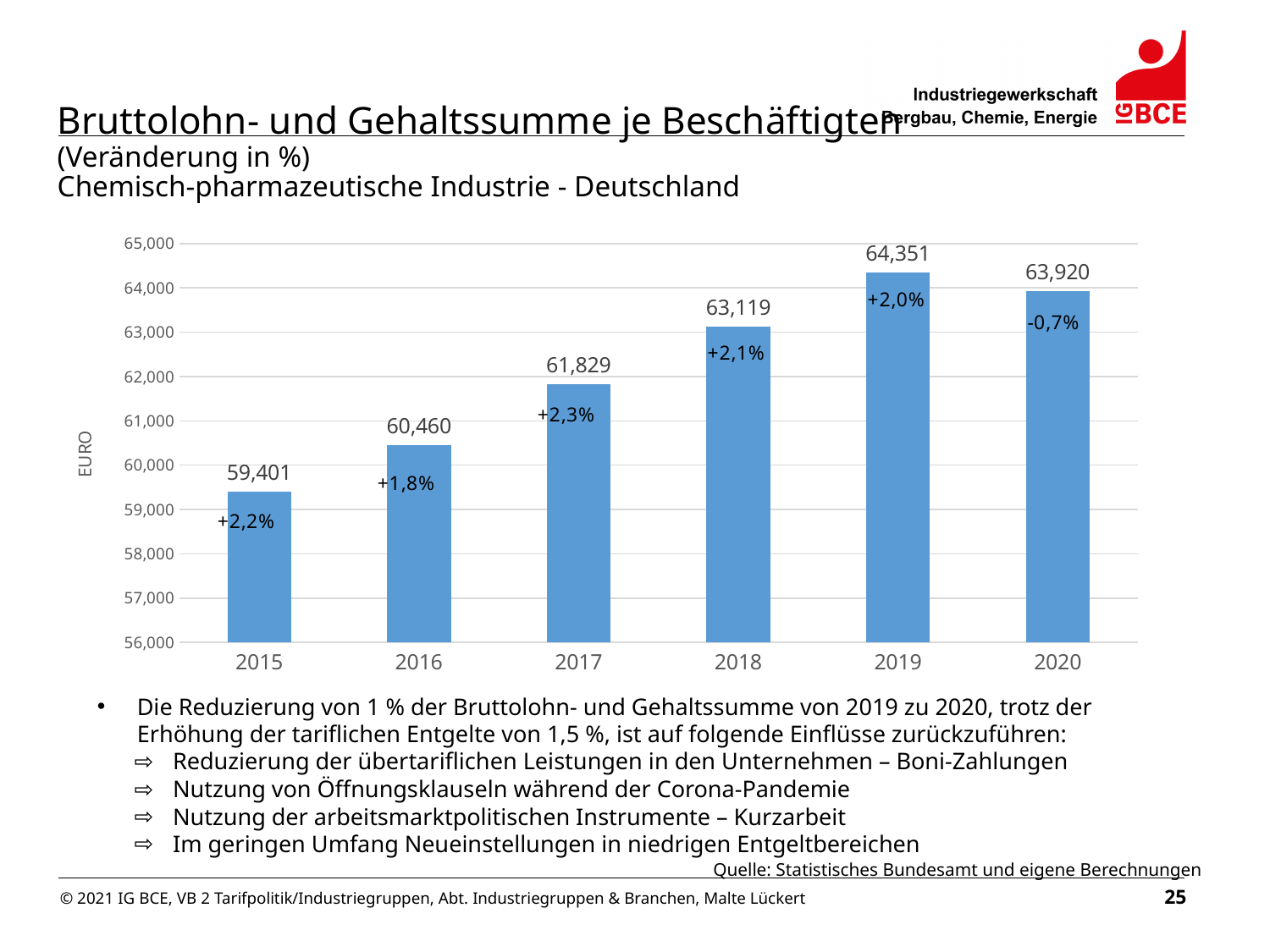
Which year has the lowest value? 2015 What is the label on the y axis? EURO What is the difference between the values for 2019 and 2020? 431 What is the value for 2020? 63,920 Which is larger, the value for 2018 or the value for 2020? 2020 Which year has the highest value? 2019 What is the value for 2017? 61,829 What percentage change is shown on the bar for 2020? -0,7% What kind of chart is this? bar chart What is the difference between the values for 2016 and 2015? 1,059 What percentage change is shown on the bar for 2016? +1,8% How many years are shown on the x axis? 6